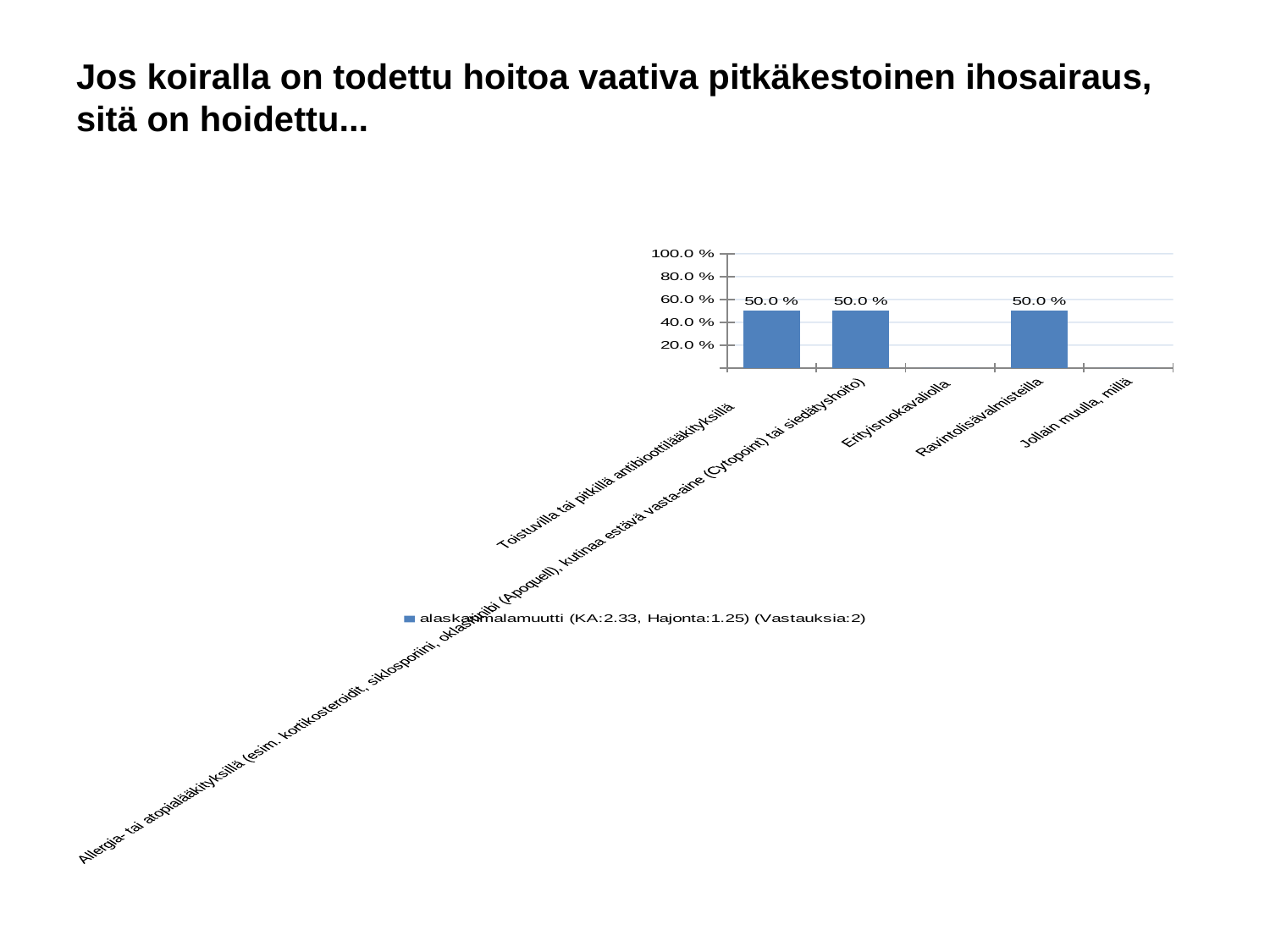
According to the legend, how many responses (Vastauksia) does the series have? 2 How many series does the legend list? 1 What is the value for the Allergia- tai atopialääkityksillä category? 50.0 % Which is larger, the value for Toistuvilla tai pitkillä antibioottilääkityksillä or the value for Erityisruokavaliolla? Toistuvilla tai pitkillä antibioottilääkityksillä Is the value for Ravintolisävalmisteilla greater or less than 40.0 %? greater Which is larger, the value for Ravintolisävalmisteilla or the value for Jollain muulla, millä? Ravintolisävalmisteilla What is the value for Ravintolisävalmisteilla? 50.0 % What is the difference between the values for Toistuvilla tai pitkillä antibioottilääkityksillä and Ravintolisävalmisteilla? 0.0 % How many categories are shown on the x axis of the chart? 5 What is the value for Toistuvilla tai pitkillä antibioottilääkityksillä? 50.0 % Is the value for Erityisruokavaliolla greater or less than 20.0 %? less What kind of chart is shown on the slide? bar chart